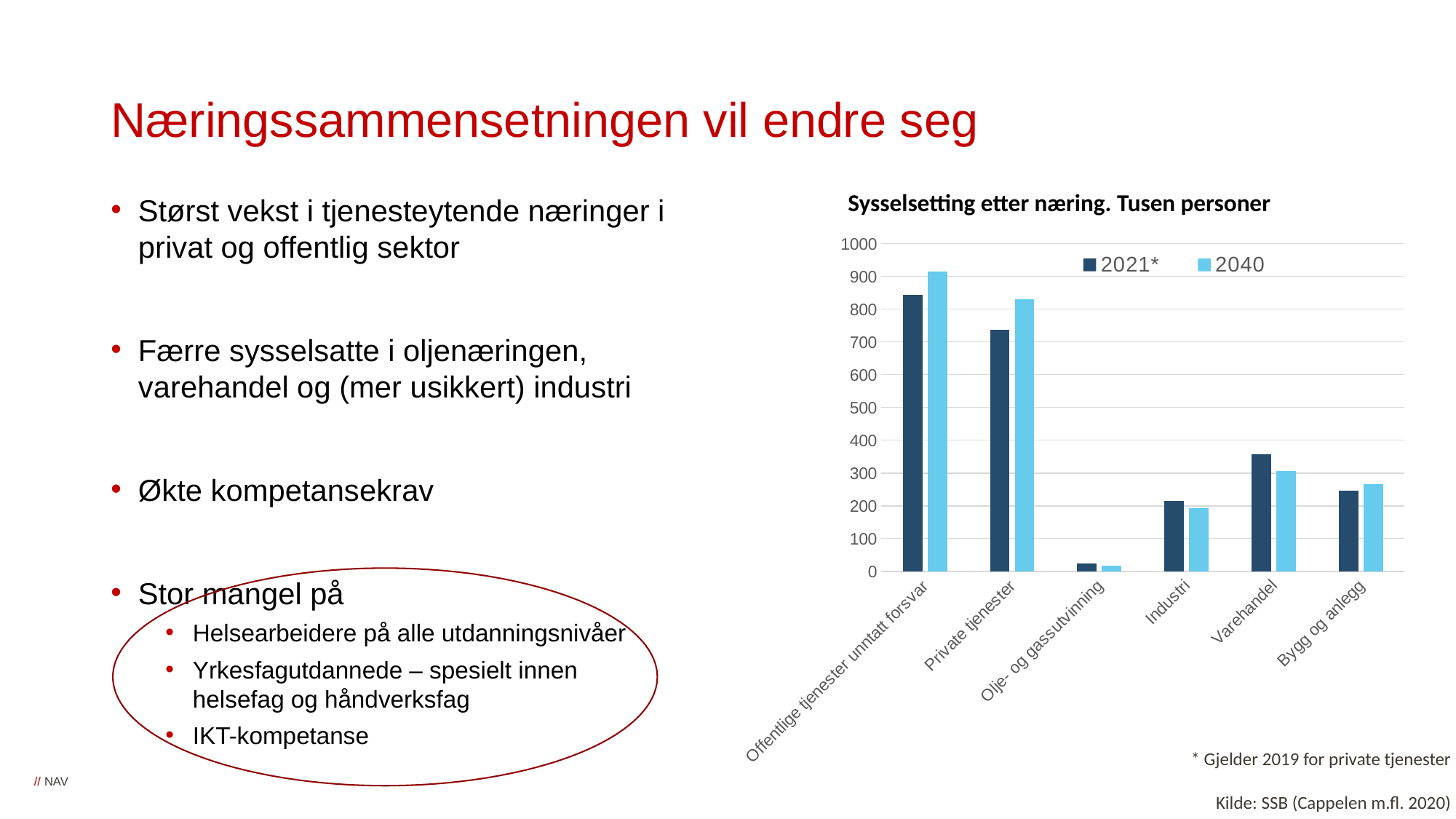
For Varehandel, which is larger: the 2021* value or the 2040 value? 2021* Which category has the highest value for 2040? Offentlige tjenester unntatt forsvar Is the 2040 value for Private tjenester greater or less than 800? greater Which category has the lowest value for 2021*? Olje- og gassutvinning What is the title of the chart? Sysselsetting etter næring. Tusen personer How many industry categories are shown on the x axis of the chart? 6 How many series does the legend of the chart list? 2 Is the 2021* value for Offentlige tjenester unntatt forsvar greater or less than 800? greater What kind of chart is shown on the slide? Bar chart Is the 2021* value for Olje- og gassutvinning greater or less than 100? less For Bygg og anlegg, which is larger: the 2021* value or the 2040 value? 2040